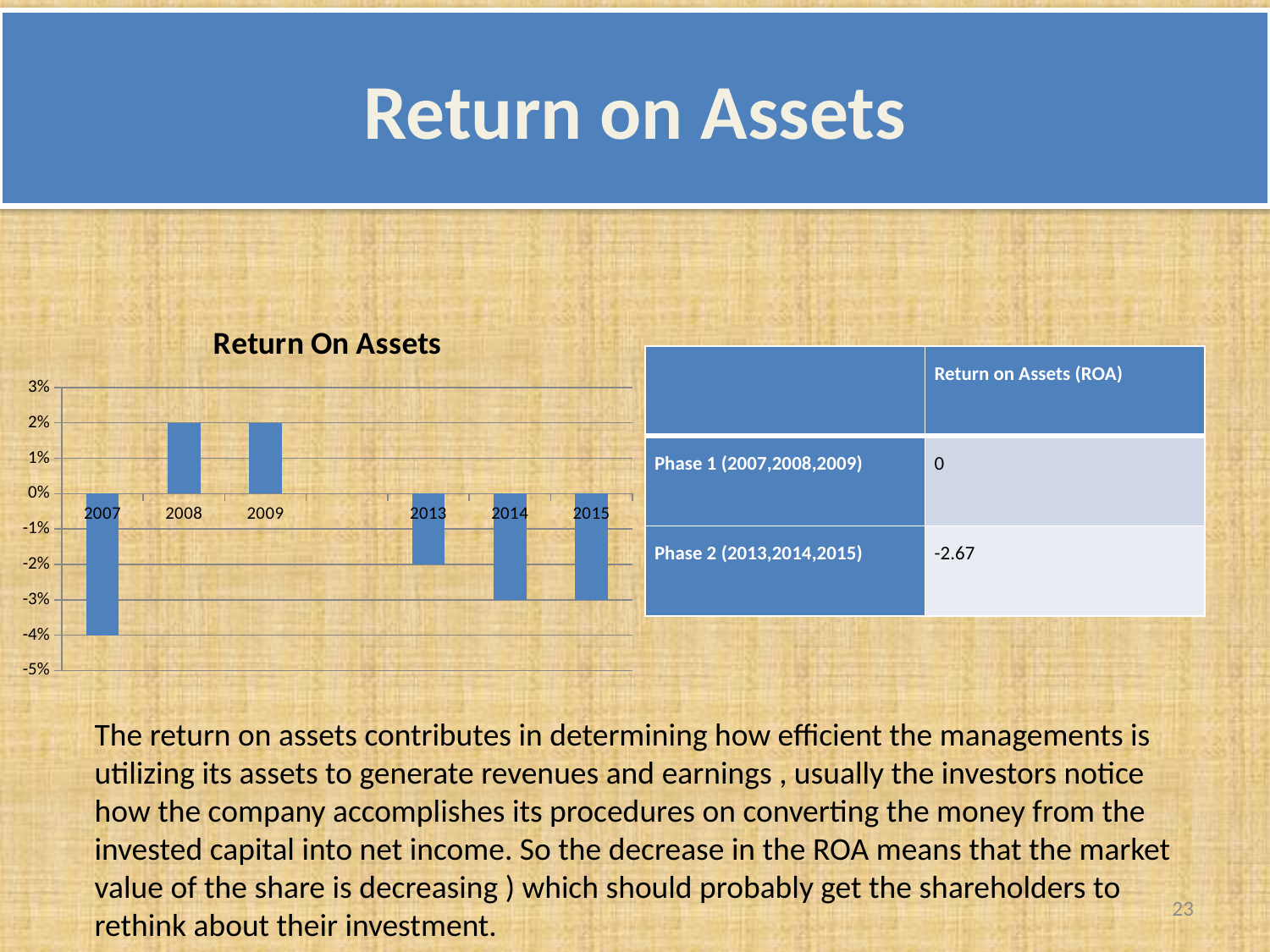
How many years are plotted on the chart? 6 What is the return on assets for 2008? 2% Which year has the lowest return on assets? 2007 Do the values rise or fall from 2009 to 2014? fall What is the return on assets for 2007? -4% Is the value for 2009 greater or less than 1%? greater What is the title of the chart? Return On Assets What kind of chart is shown on the slide? bar chart Is the value for 2015 greater or less than 0%? less Which is larger, the value for 2007 or the value for 2013? 2013 What is the return on assets for 2013? -2% What is the return on assets for 2014? -3%